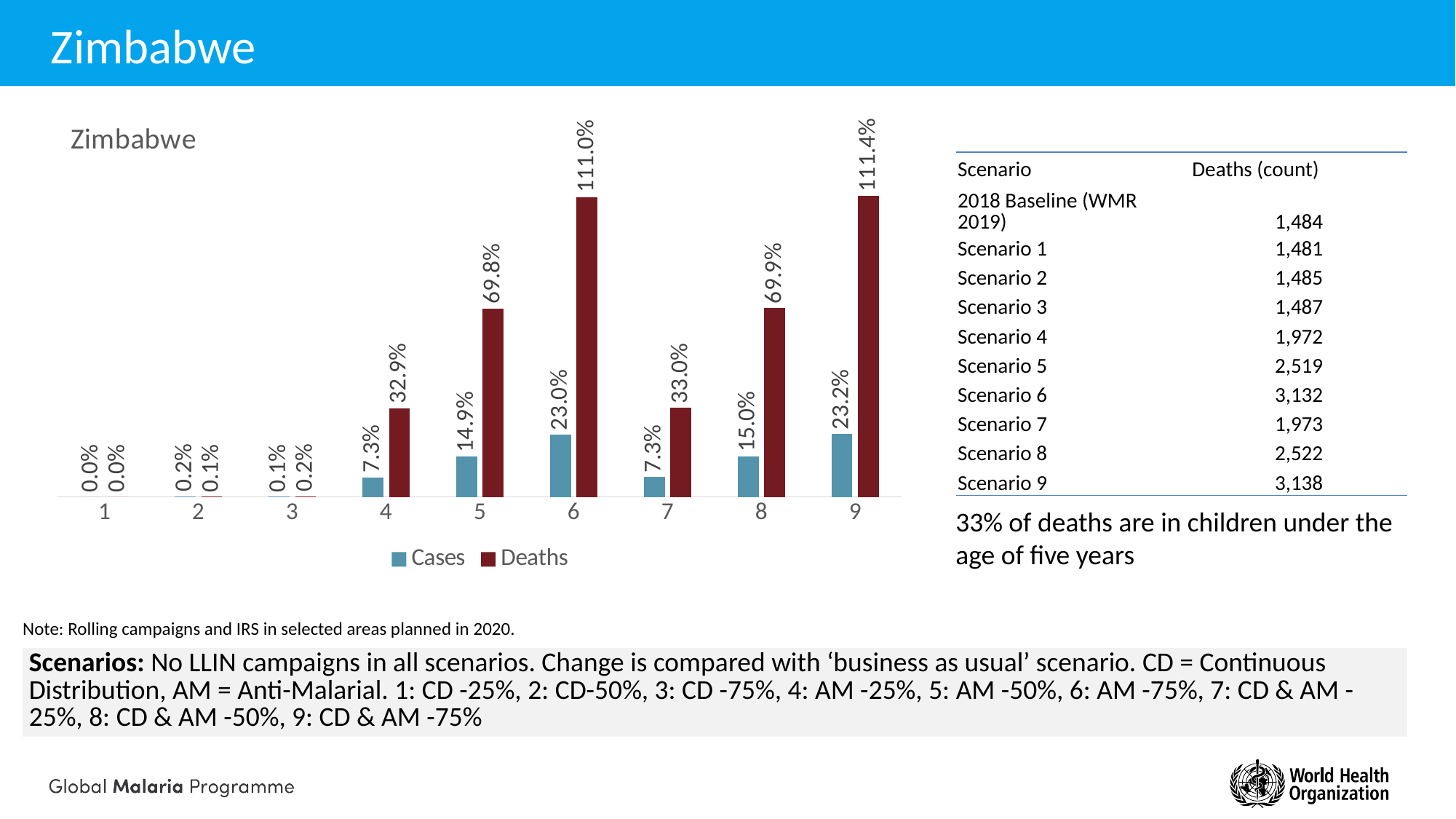
How many series does the chart legend list? 2 How many scenarios are shown on the x axis of the chart? 9 What is the Cases value for scenario 5? 14.9% What kind of chart is shown on the slide? Bar chart Which scenario has the highest Deaths value? 9 What is the title of the chart? Zimbabwe Which scenario has the lowest Cases value? 1 What is the difference between the Deaths value and the Cases value for scenario 4? 25.6% Which is larger for scenario 8: the Cases value or the Deaths value? Deaths Which colour represents the Deaths series in the chart? Dark red What is the Deaths value for scenario 6? 111.0% What is the Cases value for scenario 9? 23.2%